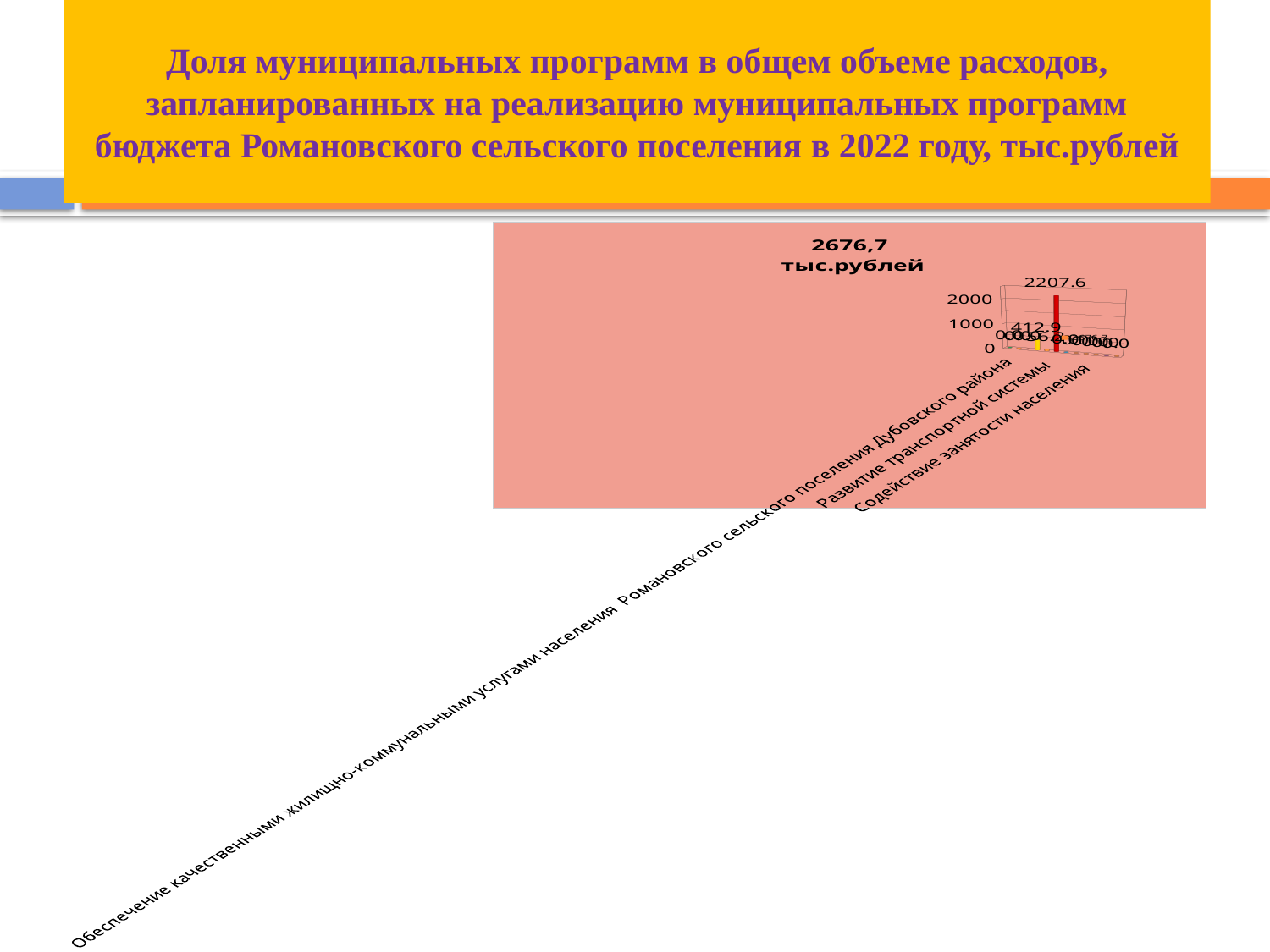
What value is labelled on the short yellow bar? 412.9 What title is printed above the chart's plot area? 2676,7 тыс.рублей Is the value of the tallest bar greater or less than 2000? greater What is the highest tick value shown on the chart's value axis? 2000 Which bar is taller, the red bar or the yellow bar? the red bar How many category labels are readable along the chart's category axis? 3 What is the difference between the values 2207.6 and 412.9 labelled on the chart? 1794.7 Is the value of the yellow bar greater or less than 1000? less What value is labelled on the tall red bar? 2207.6 What is the largest value printed as a data label on the chart? 2207.6 What kind of chart is shown on the slide? bar chart